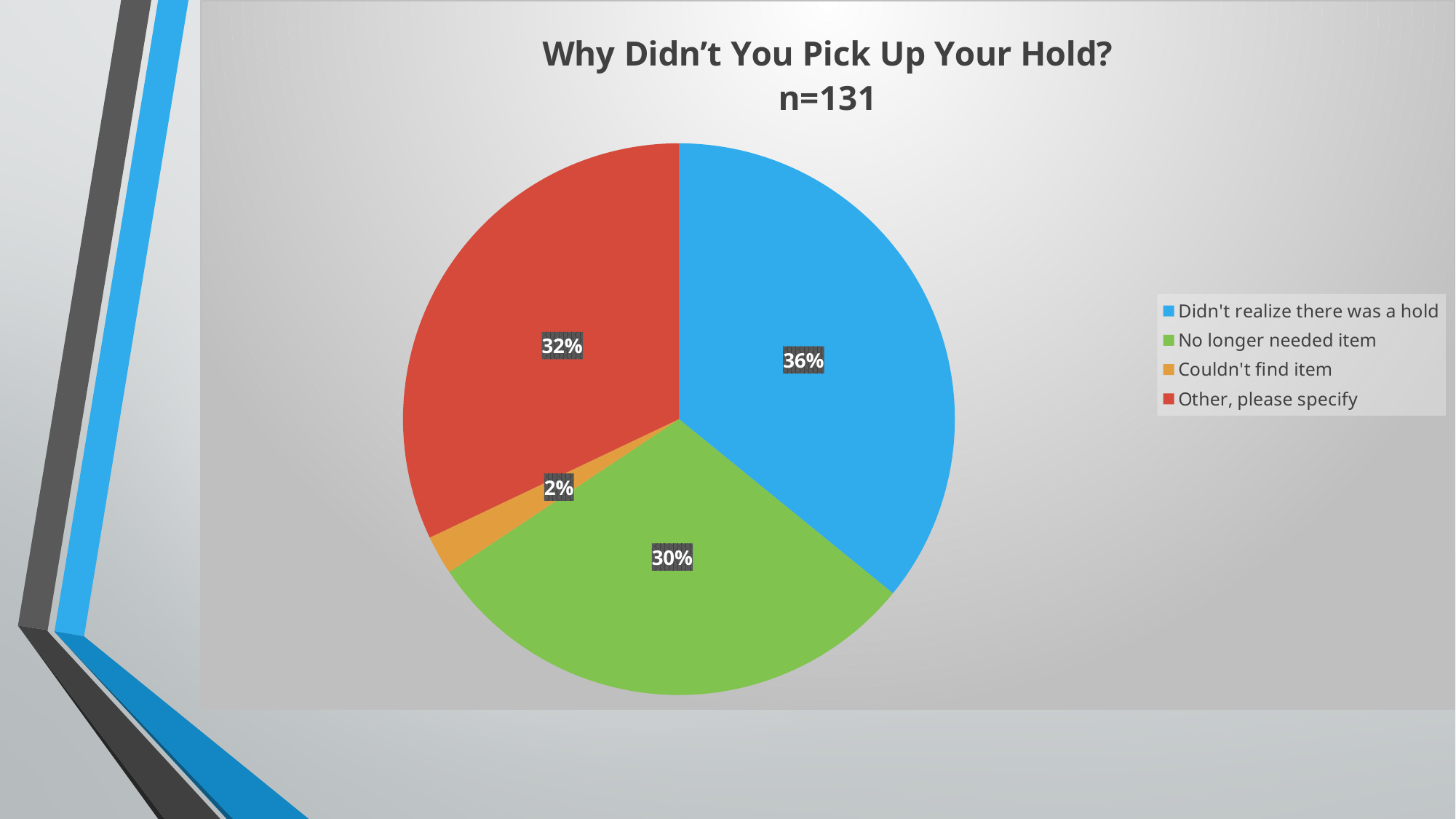
What share of respondents said they couldn't find the item? 2% Which is larger: the share for 'Other, please specify' or the share for 'No longer needed item'? Other, please specify What kind of chart is shown on the slide? pie chart What share of respondents chose 'Other, please specify'? 32% What is the difference in percentage points between 'Didn't realize there was a hold' and 'No longer needed item'? 6 Which reason has the smallest share of the pie? Couldn't find item How many slices does the pie chart have? 4 What share of respondents said they didn't realize there was a hold? 36% Which reason has the largest share of the pie? Didn't realize there was a hold What is the title of the chart? Why Didn't You Pick Up Your Hold? n=131 What colour is the slice for 'Couldn't find item'? orange